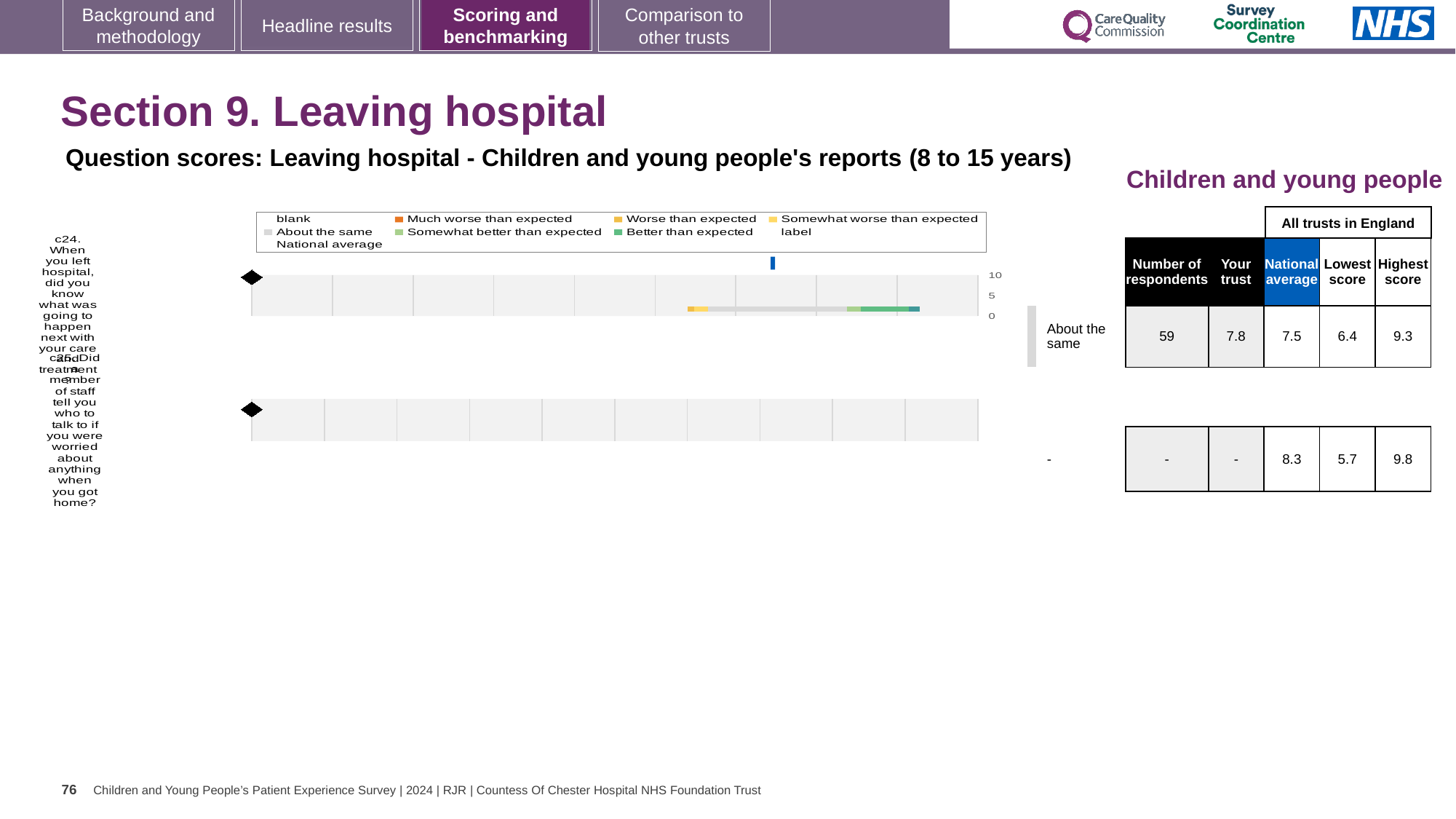
In the table beside the chart, what is the lowest score for question c25? 5.7 How many entries does the chart's legend list? 9 How many question rows (categories) are shown on the chart's vertical axis? 2 Which benchmark category label is shown next to the chart for question c24? About the same In the table beside the chart, what is the national average for question c24? 7.5 In the table beside the chart, what is the 'Your trust' score for question c24? 7.8 Which is larger for question c24: the 'Your trust' score or the national average? Your trust What is the highest tick value shown on the chart's numeric axis? 10 What kind of chart is used to show the question scores on this slide? bar chart In the table beside the chart, what is the highest score for question c25? 9.8 In the table beside the chart, what is the number of respondents for question c24? 59 What is the difference between the highest score (9.3) and the lowest score (6.4) for question c24? 2.9